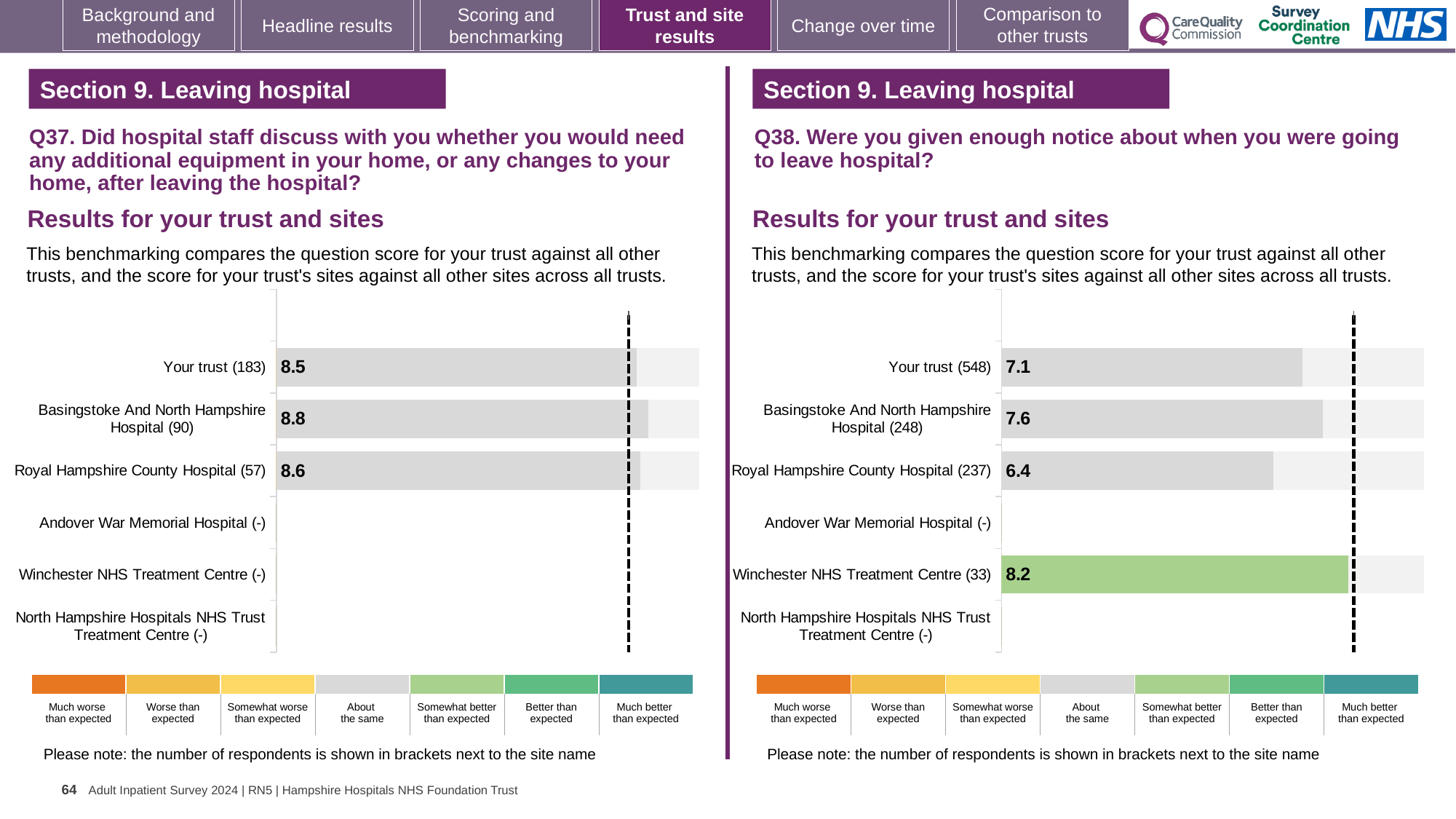
In the Q37 chart on the left, what is the score for Basingstoke And North Hampshire Hospital? 8.8 In the Q37 chart on the left, what is the score for Your trust? 8.5 In the Q38 chart on the right, which is higher: the score for Basingstoke And North Hampshire Hospital or Your trust? Basingstoke And North Hampshire Hospital In the Q38 chart on the right, how many sites have a score shown as a bar? 4 In the Q38 chart on the right, what is the score for Royal Hampshire County Hospital? 6.4 In the Q38 chart on the right, which site has the lowest score? Royal Hampshire County Hospital In the Q38 chart on the right, how many respondents are shown for Your trust? 548 In the Q37 chart on the left, which site has the highest score? Basingstoke And North Hampshire Hospital In the Q38 chart on the right, what is the score for Winchester NHS Treatment Centre? 8.2 In the Q37 chart on the left, what is the difference between the scores for Basingstoke And North Hampshire Hospital and Your trust? 0.3 What kind of chart is used in the Q37 chart on the left? Bar chart In the Q38 chart on the right, what is the difference between the scores for Winchester NHS Treatment Centre and Your trust? 1.1